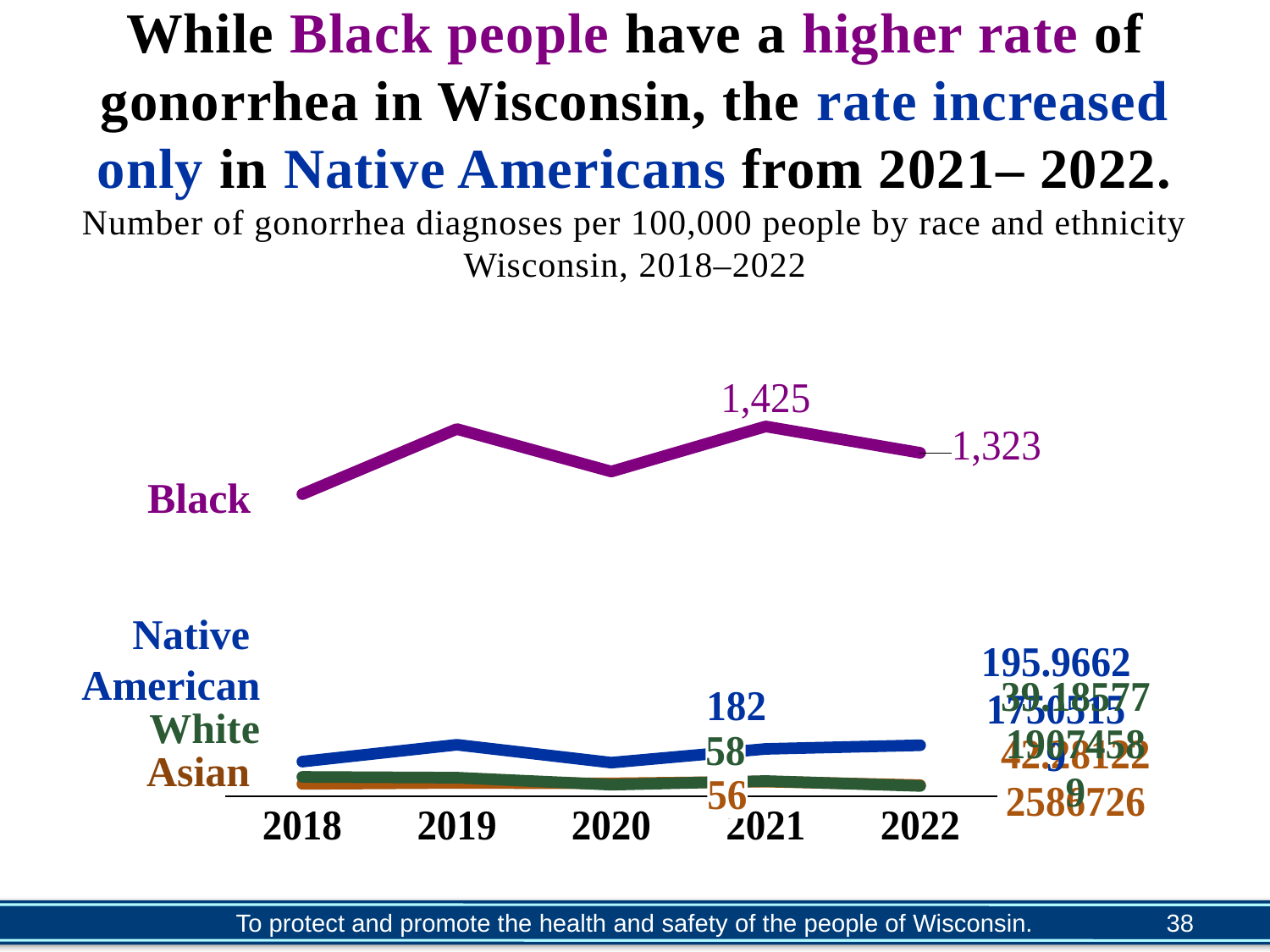
How many race and ethnicity groups are plotted on the chart? 4 What is the gonorrhea rate for Black people in 2022? 1,323 What is the gonorrhea rate for White people in 2021? 56 Which is larger, the rate for Black people in 2021 or in 2022? 2021 What kind of chart is shown on the slide? line chart By how much did the rate for Black people change from 2021 to 2022? 102 What is the gonorrhea rate for Black people in 2021? 1,425 Which race or ethnicity group has the highest gonorrhea rate across all years shown? Black How many years are shown on the x axis? 5 What is the gonorrhea rate for Native Americans in 2021? 182 Did the rate for Black people rise or fall from 2021 to 2022? fall What is the subtitle describing the chart's measure? Number of gonorrhea diagnoses per 100,000 people by race and ethnicity Wisconsin, 2018–2022